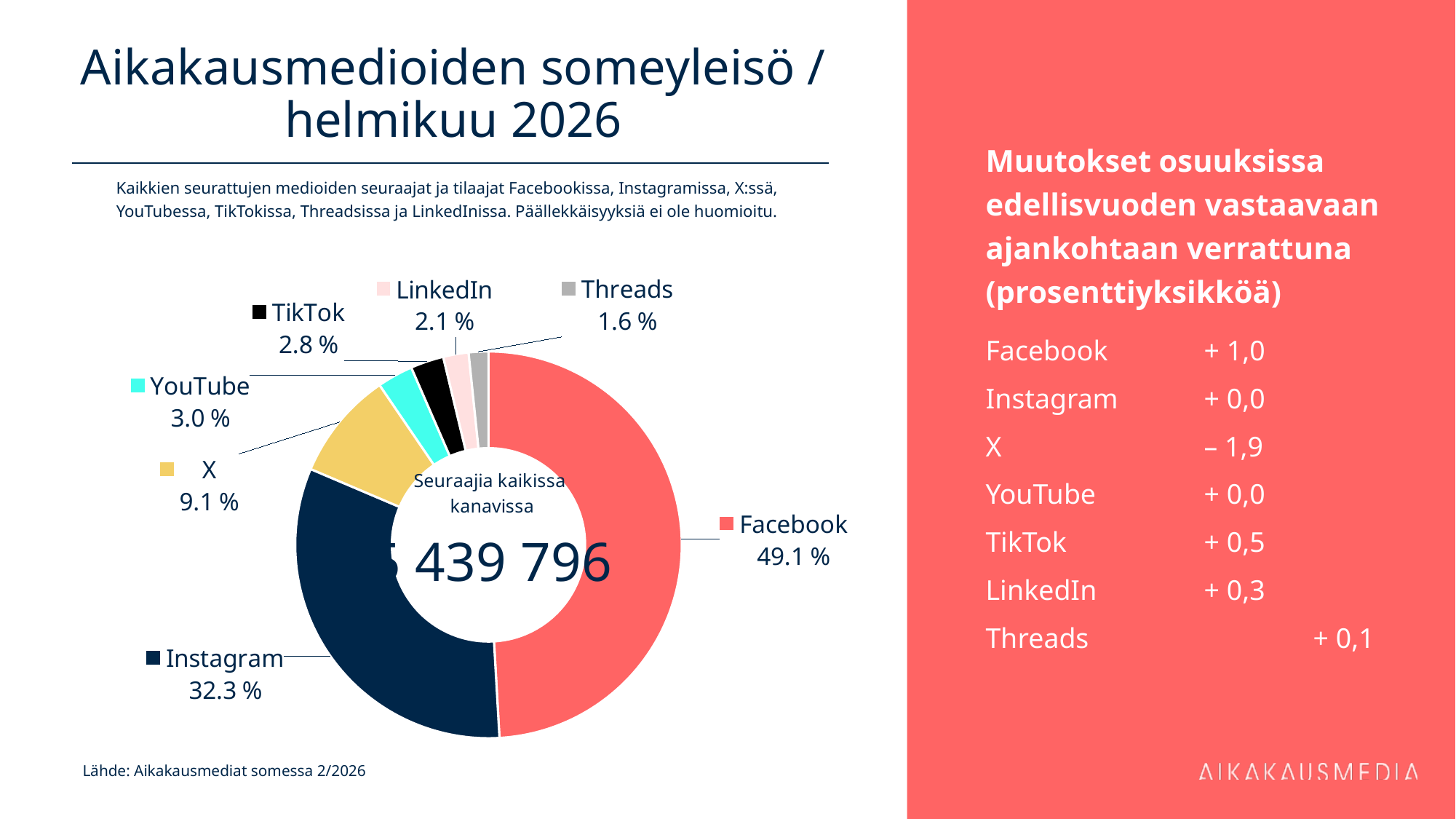
What share does X have in the chart? 9.1 % What share does TikTok have in the chart? 2.8 % How many channels (slices) are shown in the chart? 7 Which channel has the largest share in the chart? Facebook What is the combined share of LinkedIn and Threads? 3.7 % Which channel has the smallest share in the chart? Threads What kind of chart is shown on the slide? Pie chart (donut) What colour is the Facebook slice in the chart? Red (coral) What is the difference in percentage points between Facebook's and Instagram's shares? 16.8 percentage points What share of the social media audience does Instagram have? 32.3 % Which has a larger share, YouTube or LinkedIn? YouTube What share of the social media audience does Facebook have? 49.1 %